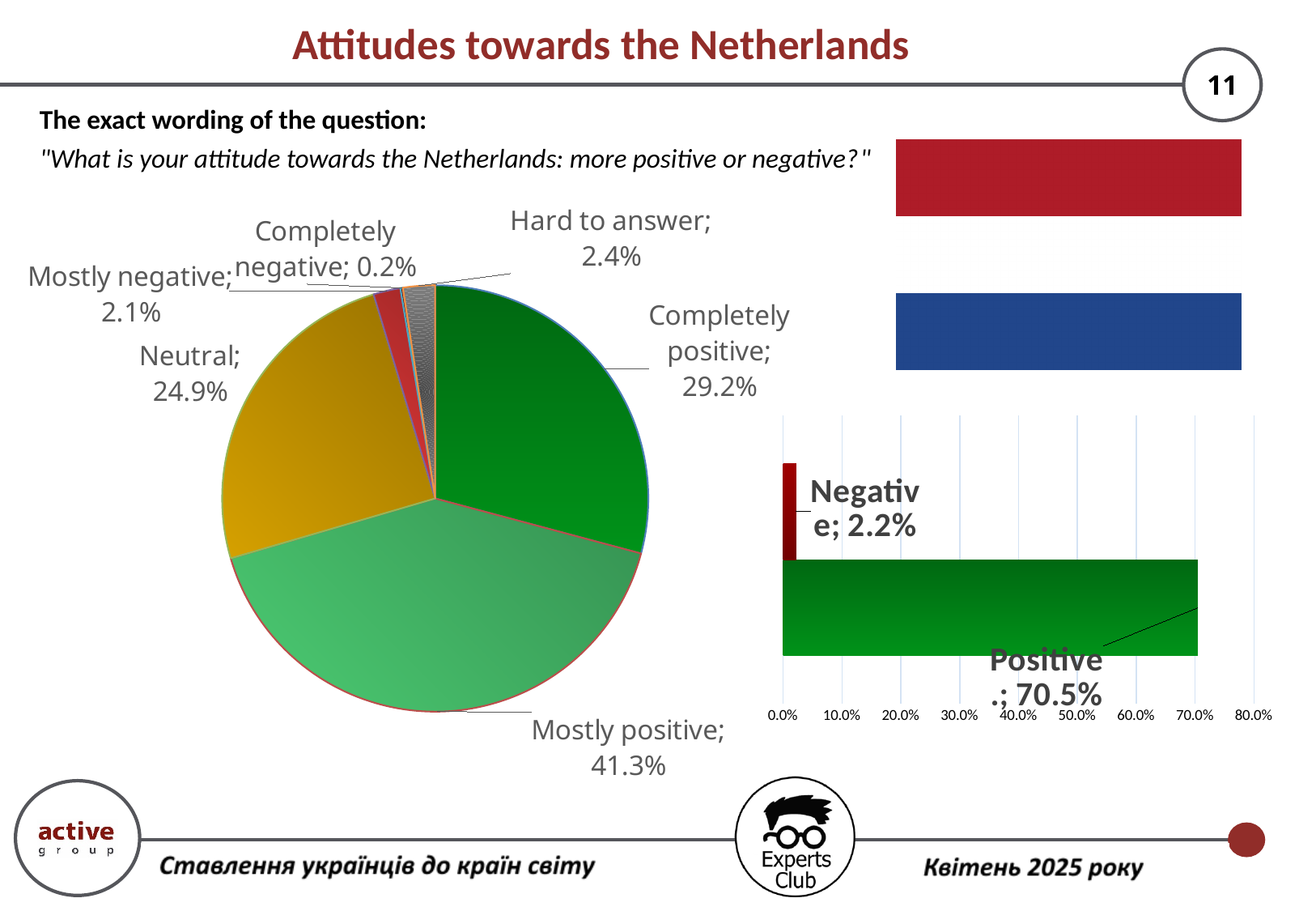
In the pie chart, what share is labelled 'Mostly positive'? 41.3% In the pie chart, which category has the smallest share? Completely negative In the pie chart, which is larger: 'Mostly negative' or 'Hard to answer'? Hard to answer In the pie chart, what share is labelled 'Hard to answer'? 2.4% What kind of chart is the one on the right with the 0.0% to 80.0% axis? Bar chart In the pie chart, which category has the largest share? Mostly positive In the pie chart, what share is labelled 'Neutral'? 24.9% In the pie chart, what share is labelled 'Completely positive'? 29.2% In the pie chart, how many slices are there? 6 In the bar chart on the right, what is the value for 'Negative'? 2.2% In the bar chart on the right, what is the value for 'Positive'? 70.5% In the pie chart, what is the difference between the 'Mostly positive' and 'Completely positive' shares? 12.1 percentage points